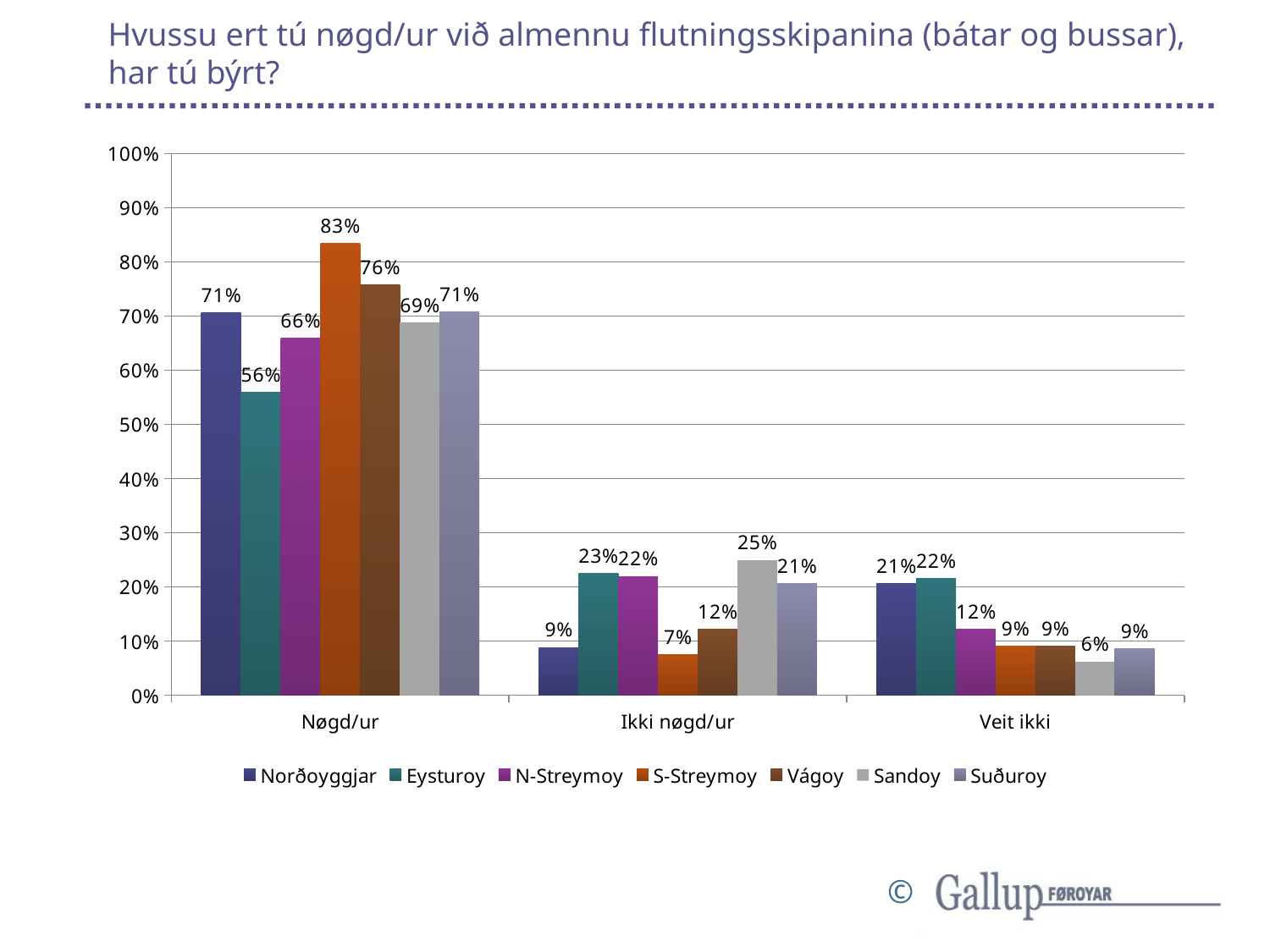
Which series has the lowest value in the Ikki nøgd/ur category? S-Streymoy How many series does the legend list? 7 What kind of chart is shown on the slide? Bar chart What is the value for Sandoy in the Veit ikki category? 6% In the Veit ikki category, which is larger: Eysturoy or N-Streymoy? Eysturoy What is the difference between the S-Streymoy and Eysturoy values in the Nøgd/ur category? 27% What is the value for Sandoy in the Ikki nøgd/ur category? 25% What is the value for Eysturoy in the Nøgd/ur category? 56% What is the value for S-Streymoy in the Nøgd/ur category? 83% How many categories are shown on the x axis? 3 Which series is shown in orange in the legend? S-Streymoy Which series has the highest value in the Nøgd/ur category? S-Streymoy